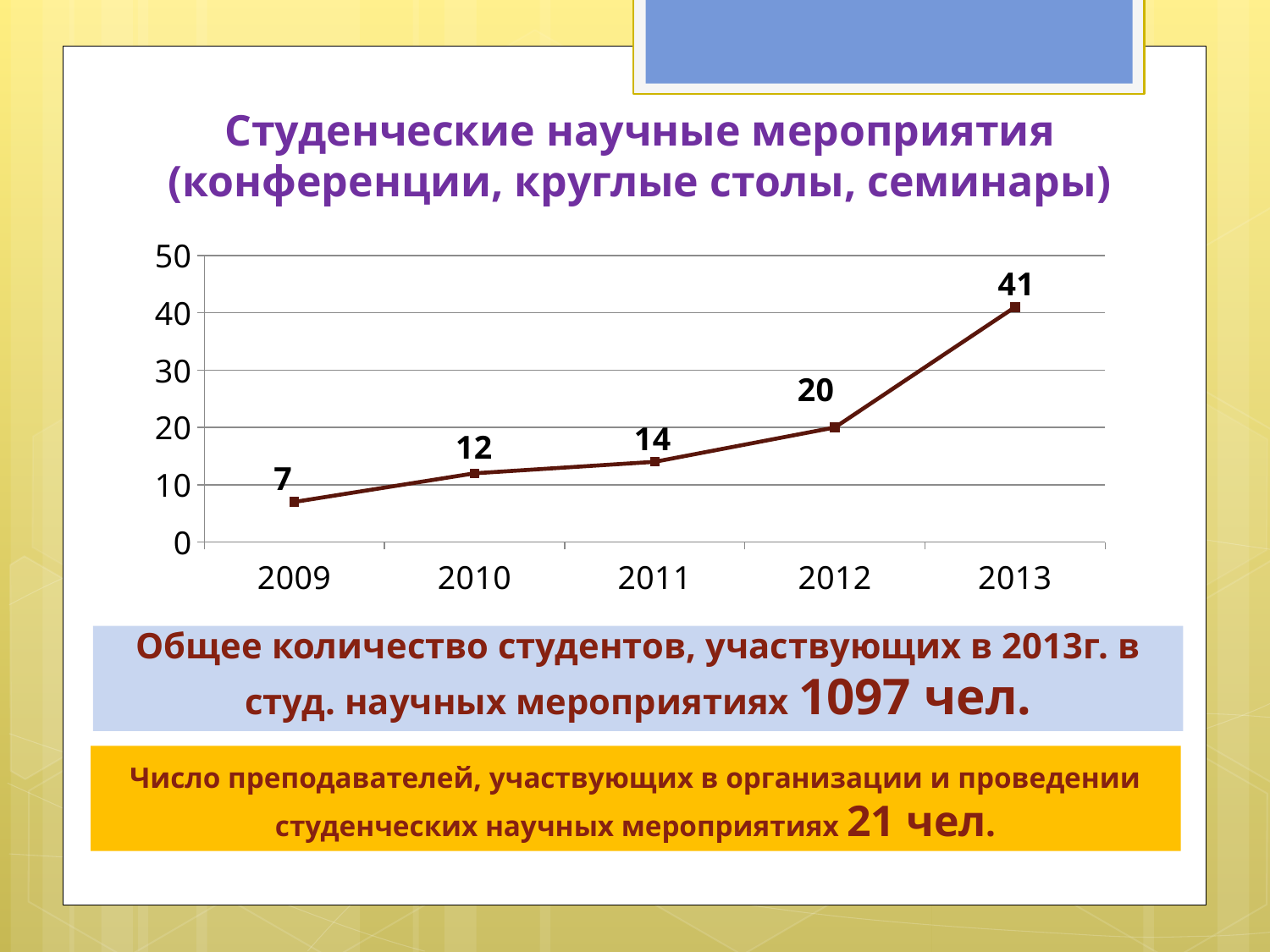
What kind of chart is shown on the slide? line chart Do the values rise or fall from 2009 to 2013? rise How many years are plotted on the chart? 5 What is the value for 2013? 41 What is the difference between the values for 2013 and 2012? 21 What is the difference between the values for 2010 and 2009? 5 What is the value for 2011? 14 Which is larger, the value for 2011 or the value for 2012? 2012 What is the value for 2009? 7 Which year has the highest value? 2013 Which year has the lowest value? 2009 Is the value for 2012 greater or less than 30? less